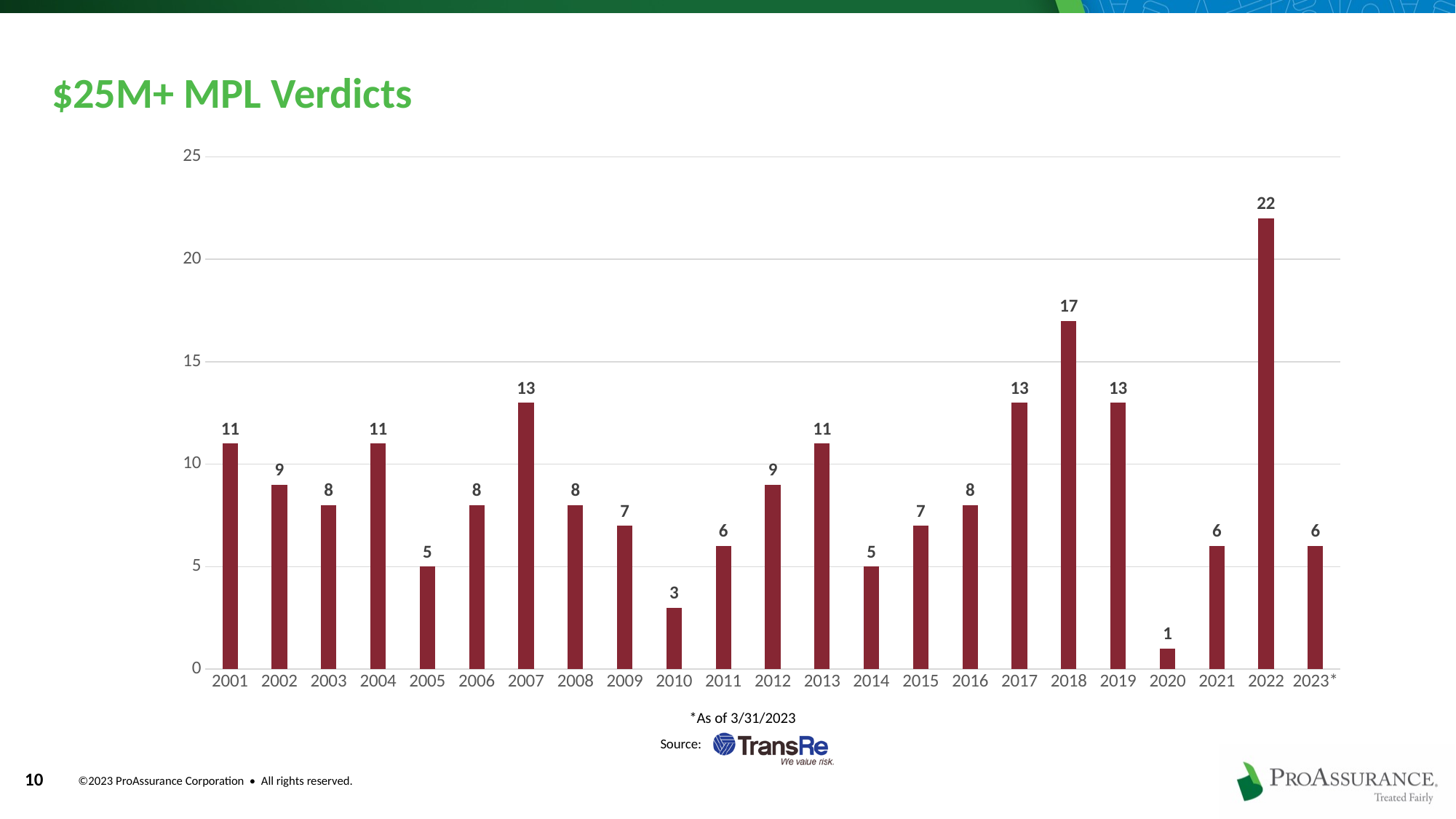
Which year has the lowest number of $25M+ MPL verdicts? 2020 What is the difference between the values for 2022 and 2018? 5 What kind of chart is shown on the slide? Bar chart Which year has the highest number of $25M+ MPL verdicts? 2022 What is the number of $25M+ MPL verdicts shown for 2022? 22 How many years are shown on the x axis? 23 What is the title of the chart? $25M+ MPL Verdicts Is the value for 2019 greater or less than 10? greater What is the value shown for 2018? 17 What is the difference between the values for 2001 and 2005? 6 Which year has a larger value, 2007 or 2012? 2007 What is the value shown for 2010? 3